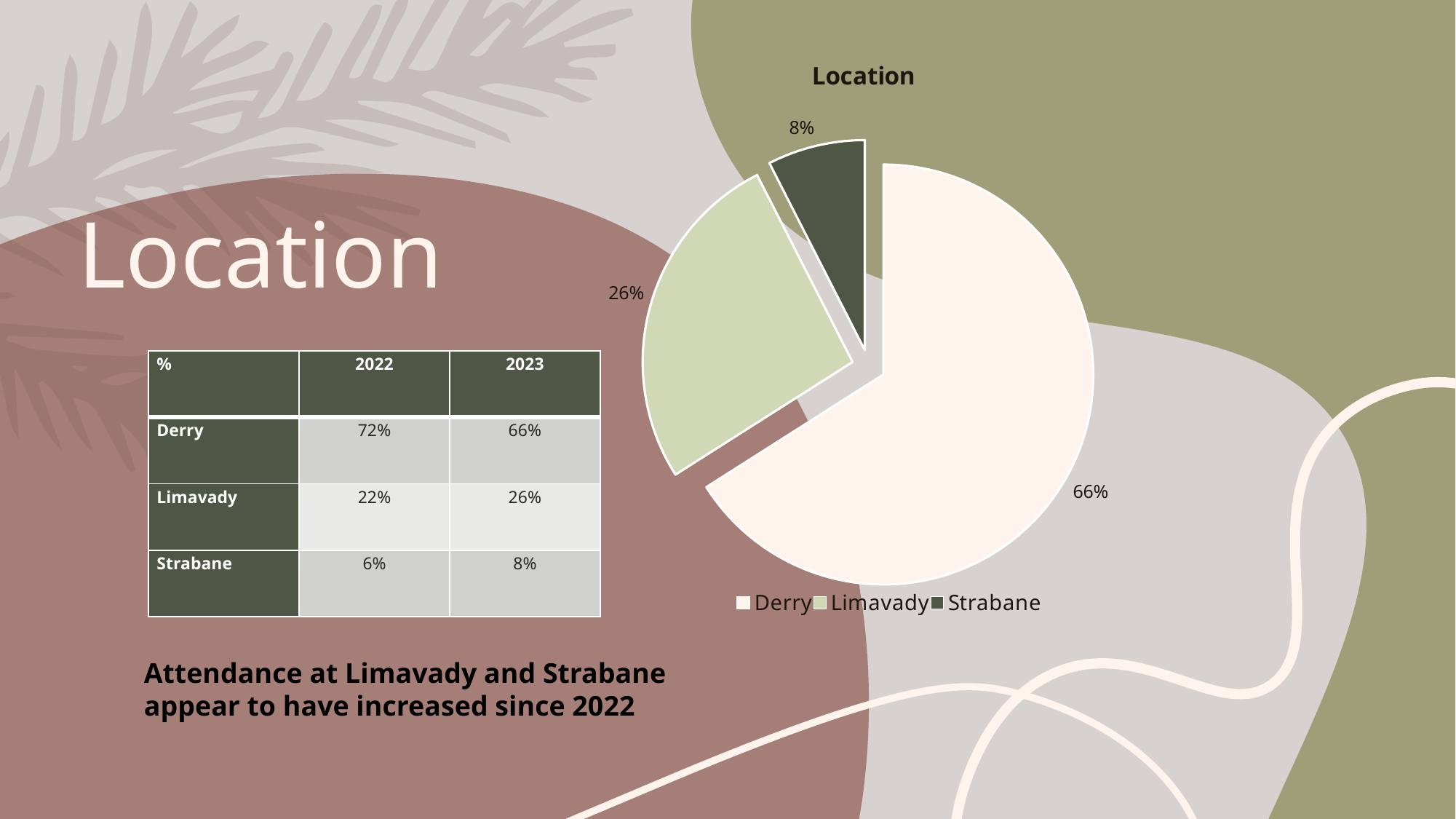
What type of chart is shown on the slide? pie chart What share of the pie does Limavady have? 26% What is the title of the chart? Location Which location has the largest slice of the pie? Derry What is the difference between the Derry and Limavady shares? 40% Which location has the smallest slice of the pie? Strabane What is the difference between the Limavady and Strabane shares? 18% How many entries does the legend list? 3 Which is larger, the Limavady slice or the Strabane slice? Limavady What share of the pie does Derry have? 66% How many slices does the pie chart have? 3 What share of the pie does Strabane have? 8%